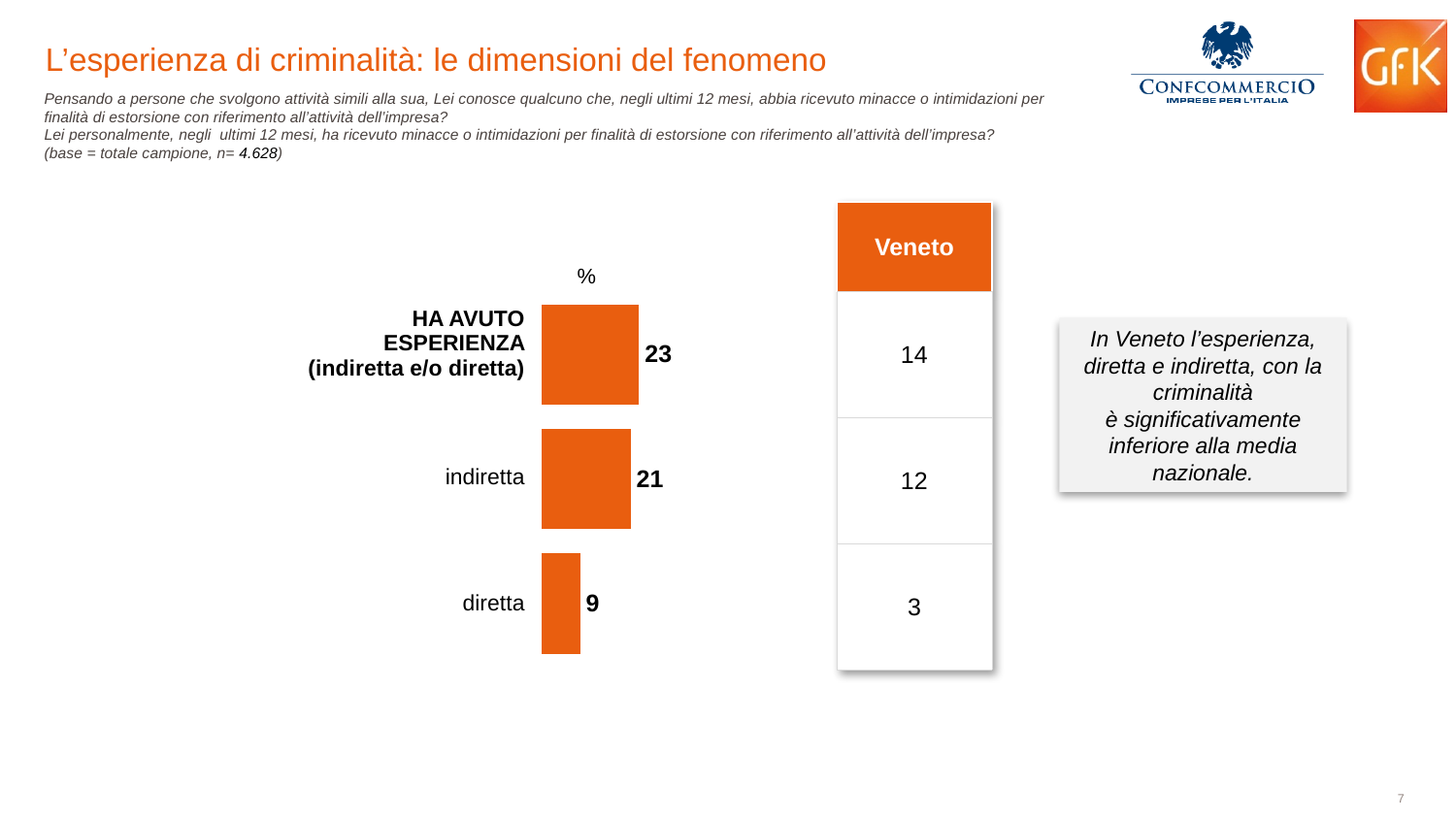
What is the value for 'HA AVUTO ESPERIENZA (indiretta e/o diretta)' in the bar chart? 23 Which category has the lowest value in the bar chart? diretta What unit is indicated above the bars in the chart? % Which is larger in the bar chart, the value for 'indiretta' or the value for 'diretta'? indiretta In the Veneto column next to the chart, what is the value for 'diretta'? 3 What is the value for 'diretta' in the bar chart? 9 Which category has the highest value in the bar chart? HA AVUTO ESPERIENZA (indiretta e/o diretta) What is the difference between the national value for 'HA AVUTO ESPERIENZA (indiretta e/o diretta)' in the bar chart and the Veneto value for the same row? 9 What type of chart is shown on the slide? Bar chart What is the difference between the values for 'indiretta' and 'diretta' in the bar chart? 12 What is the value for 'indiretta' in the bar chart? 21 How many categories are shown in the bar chart? 3